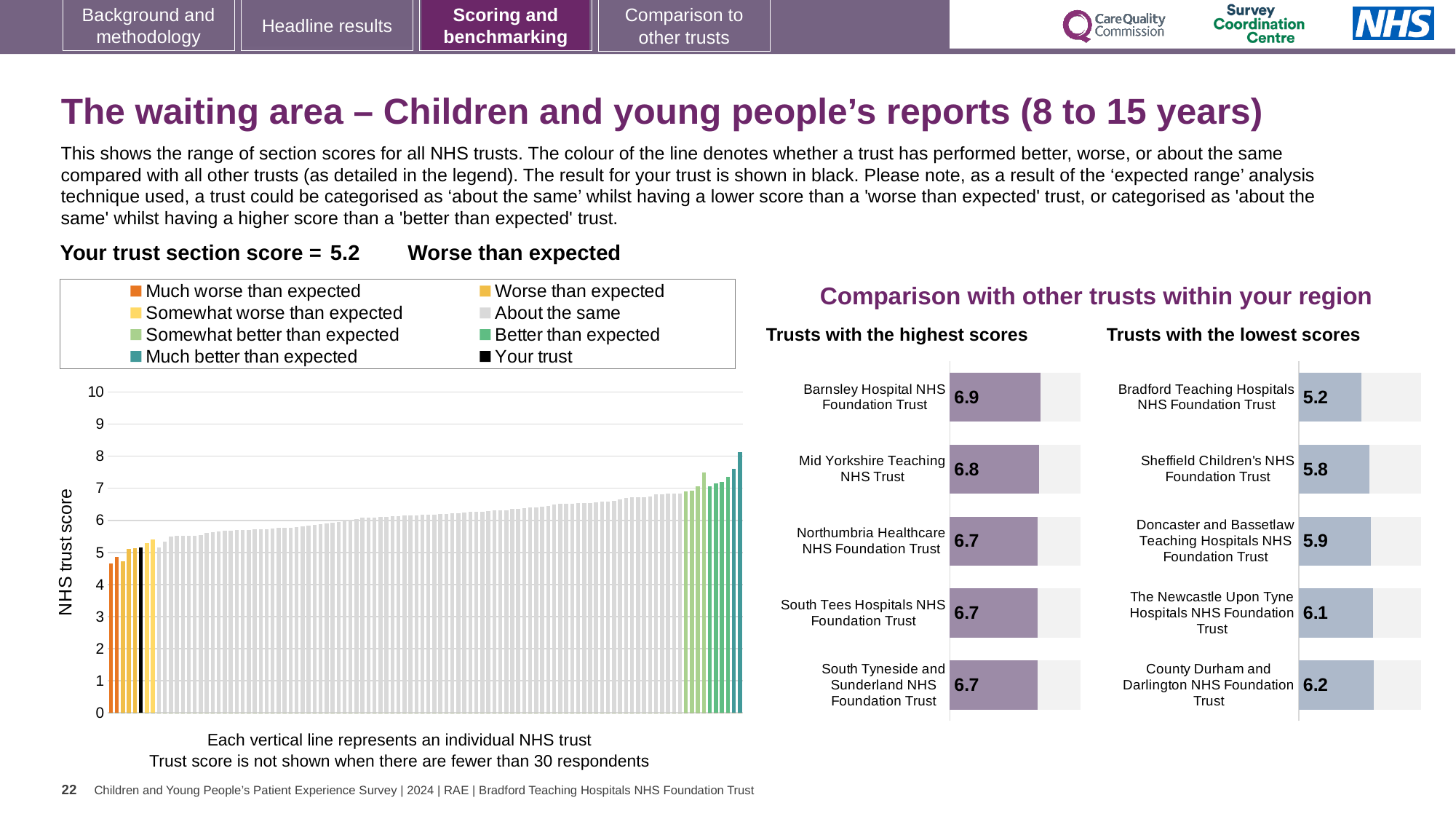
In the 'Trusts with the lowest scores' chart, which trust has the lowest score? Bradford Teaching Hospitals NHS Foundation Trust How many trusts are shown in the 'Trusts with the lowest scores' chart? 5 How many entries does the legend above the large chart on the left list? 8 In the 'Trusts with the lowest scores' chart, what is the score for Bradford Teaching Hospitals NHS Foundation Trust? 5.2 In the large chart on the left, is the value for the black 'Your trust' bar greater or less than 6? less In the 'Trusts with the highest scores' chart, which trust has the highest score? Barnsley Hospital NHS Foundation Trust In the large chart on the left, what is the label on the vertical axis? NHS trust score In the large chart on the left, is the value of the tallest bar greater or less than 7? greater In the 'Trusts with the highest scores' chart, what is the difference between the scores of Barnsley Hospital NHS Foundation Trust and Mid Yorkshire Teaching NHS Trust? 0.1 In the 'Trusts with the lowest scores' chart, which has the higher score: Sheffield Children's NHS Foundation Trust or Doncaster and Bassetlaw Teaching Hospitals NHS Foundation Trust? Doncaster and Bassetlaw Teaching Hospitals NHS Foundation Trust In the 'Trusts with the highest scores' chart, what is the score for Barnsley Hospital NHS Foundation Trust? 6.9 What kind of chart is the large chart on the left showing NHS trust scores? Bar chart